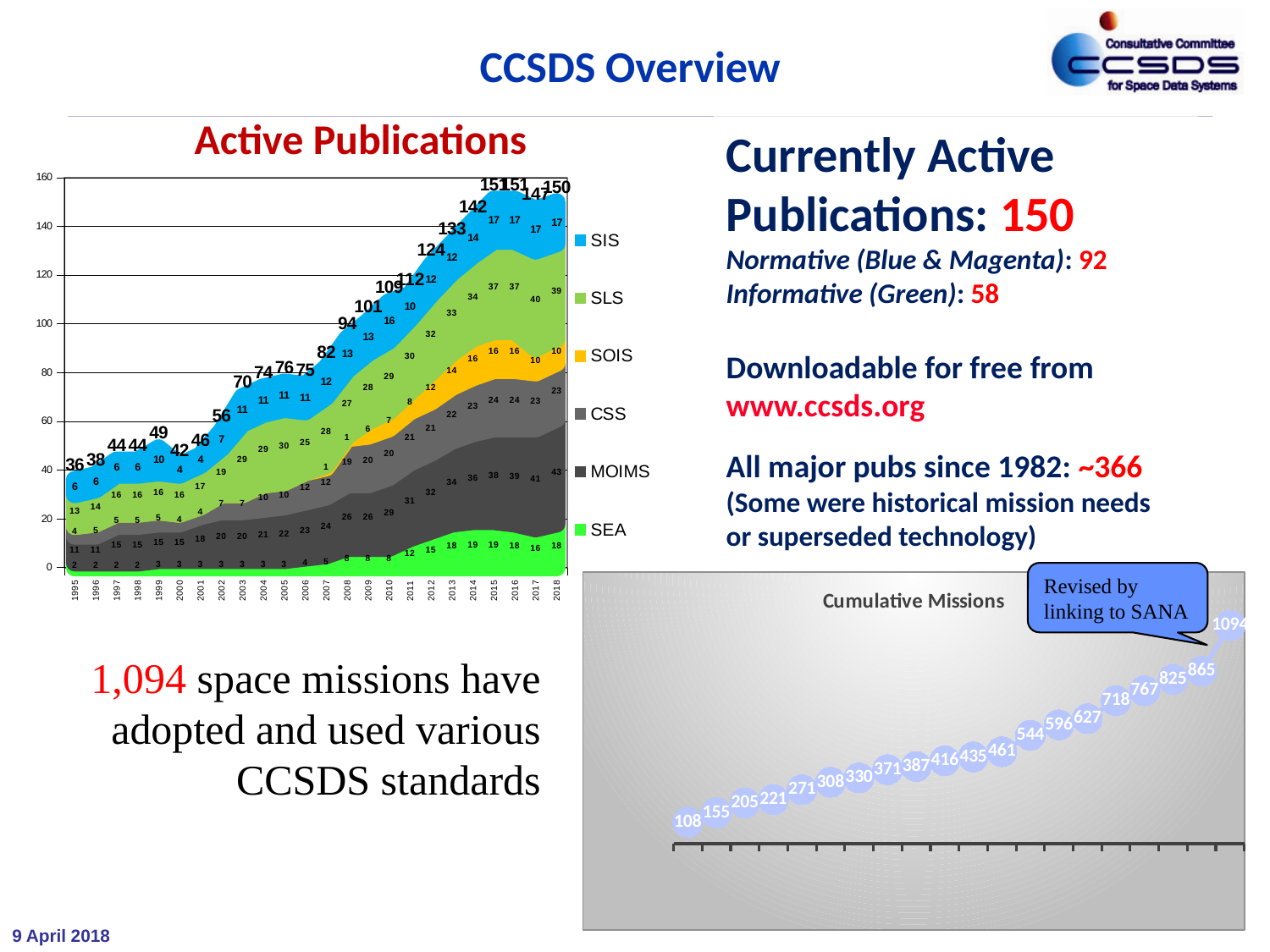
In the Active Publications chart, do the total active publications generally rise or fall from 1995 to 2018? rise In the Active Publications chart, what is the MOIMS value in 2018? 43 In the Active Publications chart, what kind of chart is used to show the data? area chart In the Cumulative Missions chart, what is the highest value shown? 1094 In the Active Publications chart, what is the total number of active publications in 1995? 36 In the Cumulative Missions chart, what is the lowest value shown? 108 In the Cumulative Missions chart, what kind of chart is used? line chart In the Active Publications chart, what is the difference between the total for 2018 and the total for 1995? 114 In the Active Publications chart, how many years are shown on the x axis? 24 In the Active Publications chart, what is the total number of active publications in 2018? 150 In the Active Publications chart, which year has the lowest total of active publications? 1995 In the Active Publications chart, how many series does the legend list? 6